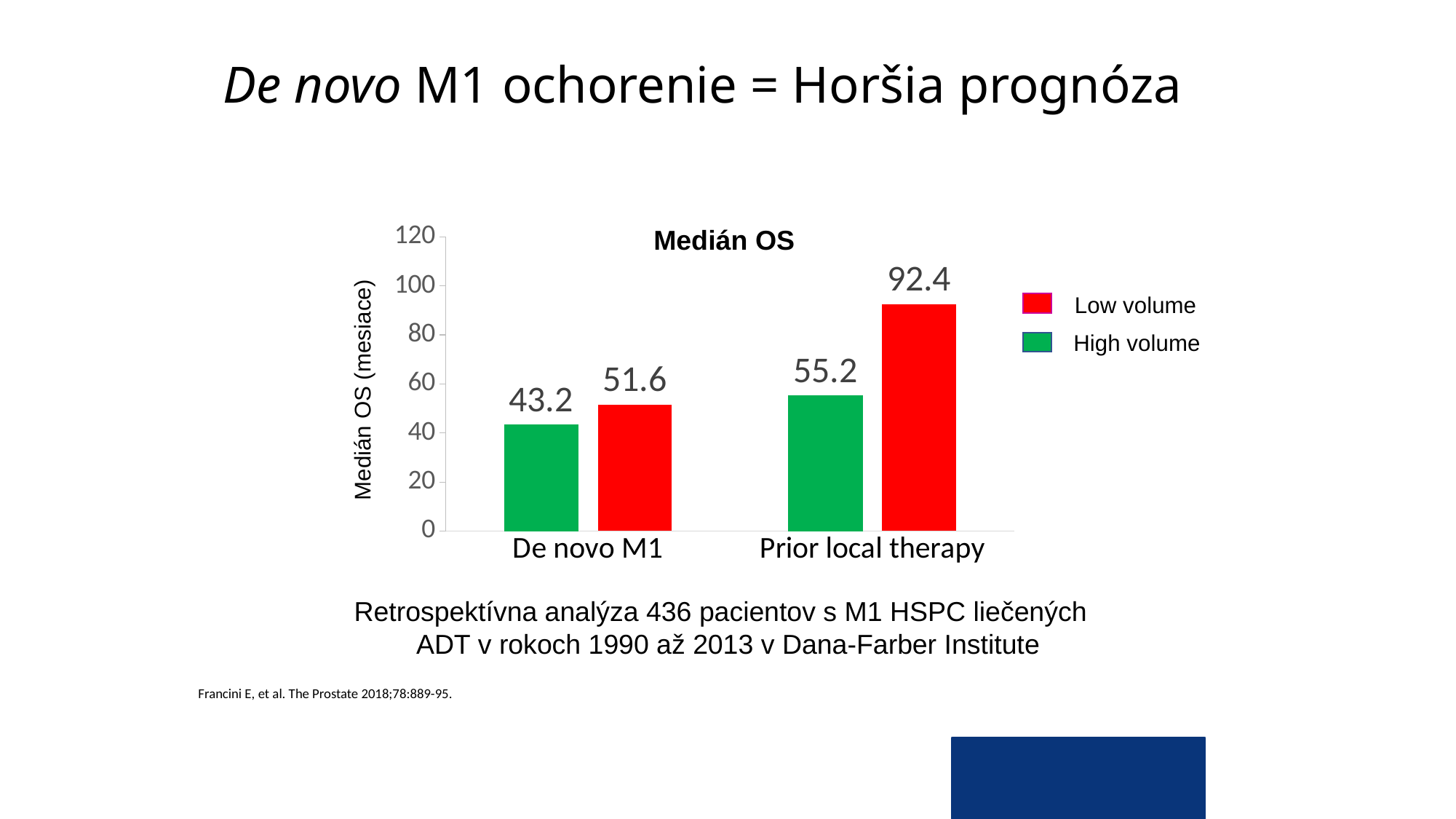
What is the difference between the Low volume and High volume median OS in the Prior local therapy group? 37.2 What type of chart is shown? Bar chart What is the median OS for High volume in the De novo M1 group? 43.2 Which bar has the highest median OS value? Low volume, Prior local therapy Which bar has the lowest median OS value? High volume, De novo M1 How many series does the legend list? 2 What is the median OS for Low volume in the De novo M1 group? 51.6 Is the Low volume median OS for Prior local therapy greater or less than 80? greater How many categories are shown on the x axis? 2 What is the median OS for Low volume in the Prior local therapy group? 92.4 Which is larger: the Low volume median OS for De novo M1 or the High volume median OS for Prior local therapy? High volume for Prior local therapy What is the difference in High volume median OS between Prior local therapy and De novo M1? 12.0